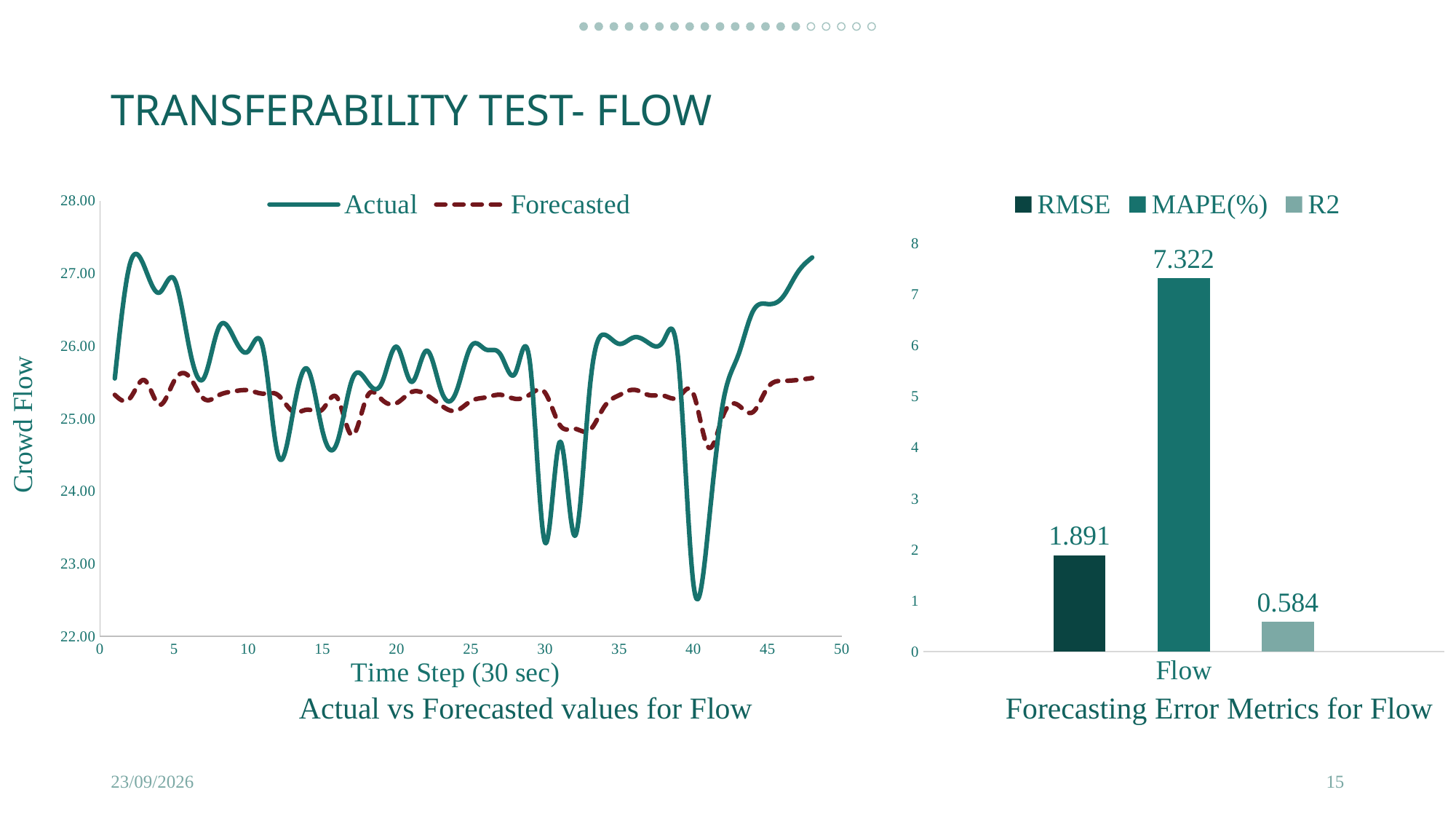
In the 'Forecasting Error Metrics for Flow' chart, what is the difference between the MAPE(%) and RMSE values? 5.431 What kind of chart is 'Actual vs Forecasted values for Flow'? Line chart In the 'Forecasting Error Metrics for Flow' chart, which metric has the lowest value? R2 In the 'Actual vs Forecasted values for Flow' chart, how many series does the legend list? 2 In the 'Forecasting Error Metrics for Flow' chart, what is the value of RMSE? 1.891 In the 'Forecasting Error Metrics for Flow' chart, which metric has the highest value? MAPE(%) In the 'Forecasting Error Metrics for Flow' chart, what is the value of R2? 0.584 In the 'Actual vs Forecasted values for Flow' chart, what is the label of the y axis? Crowd Flow In the 'Forecasting Error Metrics for Flow' chart, how many series does the legend list? 3 In the 'Forecasting Error Metrics for Flow' chart, what is the value of MAPE(%)? 7.322 What kind of chart is 'Forecasting Error Metrics for Flow'? Bar chart In the 'Actual vs Forecasted values for Flow' chart, is the Actual value at time step 40 greater or less than 23.00? less